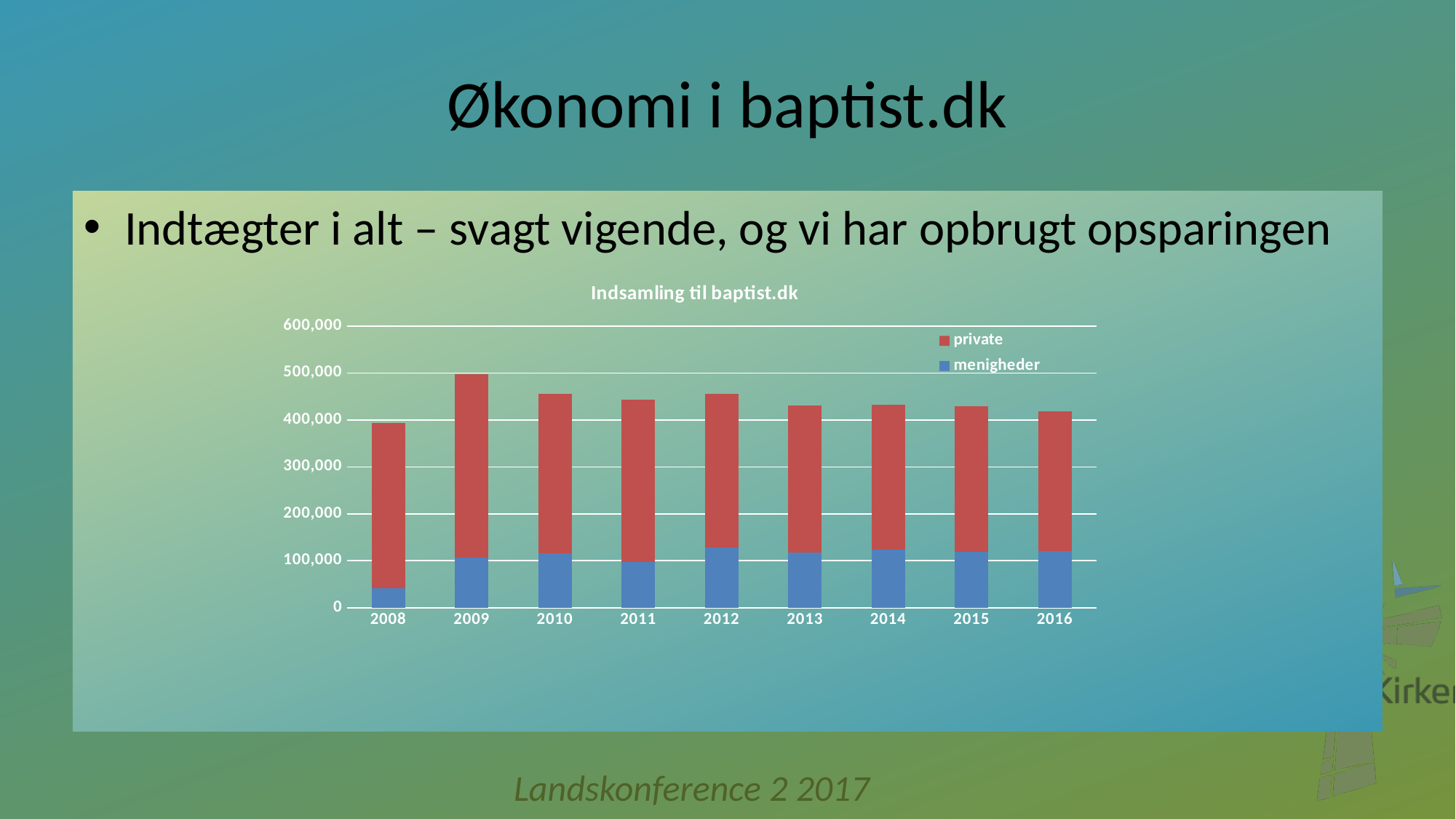
How many years are shown on the x axis of the chart? 9 Which year has the smallest menigheder value? 2008 Is the menigheder value for 2012 greater or less than 100,000? greater What kind of chart is shown on the slide? stacked bar chart Which series are listed in the chart's legend? private, menigheder Is the total bar for 2016 greater or less than 400,000? greater Which year has the lowest total bar in the chart? 2008 What is the title of the chart? Indsamling til baptist.dk How many series does the chart's legend list? 2 Which year has the larger total bar, 2008 or 2009? 2009 Which year has the highest total bar in the chart? 2009 Is the menigheder value for 2008 greater or less than 100,000? less